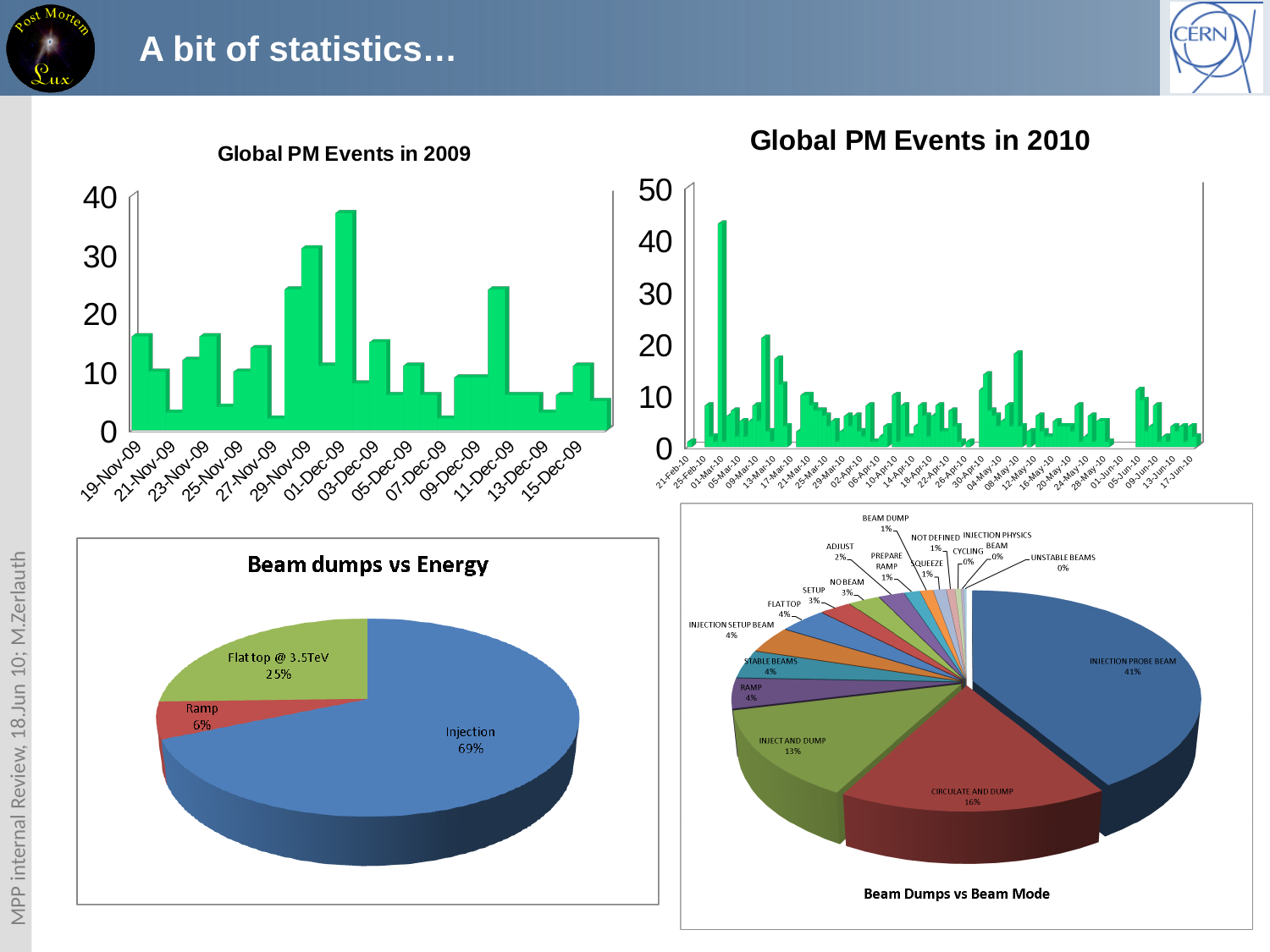
In the Beam dumps vs Energy pie chart, what percentage is shown for Ramp? 6% In the Global PM Events in 2010 chart, is the tallest bar greater or less than 40? greater In the Beam dumps vs Energy pie chart, what share of beam dumps occurred at Injection? 69% How many slices does the Beam dumps vs Energy pie chart have? 3 In the Beam dumps vs Energy pie chart, which category has the smallest share? Ramp What kind of chart is Global PM Events in 2009? bar chart In the Beam dumps vs Energy pie chart, what is the difference between the Injection share and the Flat top @ 3.5TeV share? 44% In the Beam Dumps vs Beam Mode pie chart, which beam mode has the largest share? INJECTION PROBE BEAM In the Global PM Events in 2009 chart, is the tallest bar greater or less than 30? greater In the Beam Dumps vs Beam Mode pie chart, what percentage is shown for CIRCULATE AND DUMP? 16% In the Beam Dumps vs Beam Mode pie chart, what percentage is shown for INJECT AND DUMP? 13% In the Beam Dumps vs Beam Mode pie chart, which is larger: INJECT AND DUMP or CIRCULATE AND DUMP? CIRCULATE AND DUMP